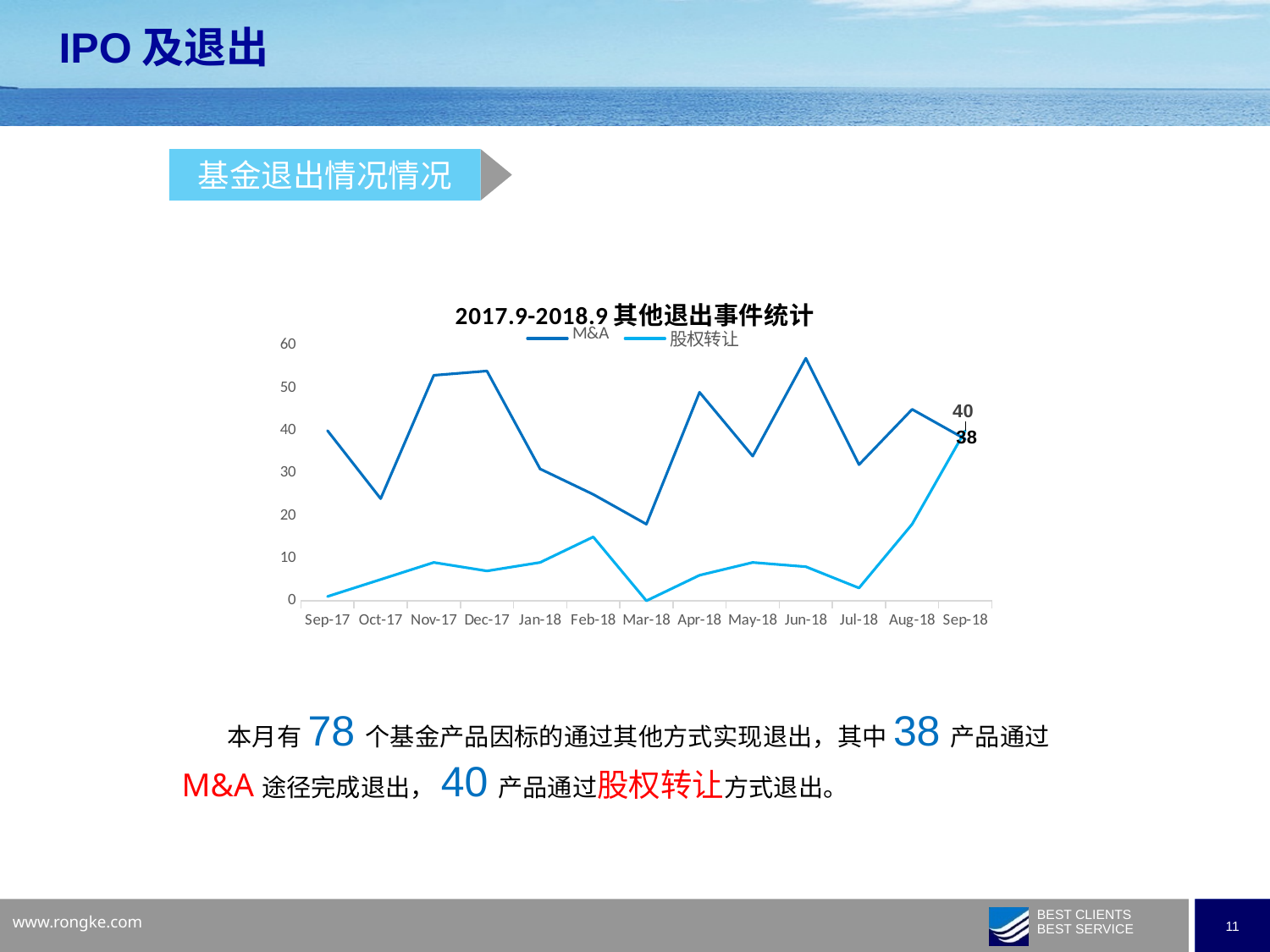
What is the difference between the 股权转让 value and the M&A value for Sep-18? 2 For Sep-18, which series has the larger value, M&A or 股权转让? 股权转让 How many months are plotted along the x axis of the chart? 13 What kind of chart is shown on the slide? line chart What is the title of the chart? 2017.9-2018.9 其他退出事件统计 What is the value of the 股权转让 series for Sep-18? 40 In which month is the 股权转让 series at its highest? Sep-18 In which month is the M&A series at its lowest? Mar-18 How many series does the chart's legend list? 2 What is the value of the M&A series for Sep-18? 38 Is the M&A value for Nov-17 greater or less than 50? greater In which month is the 股权转让 series at its lowest? Mar-18